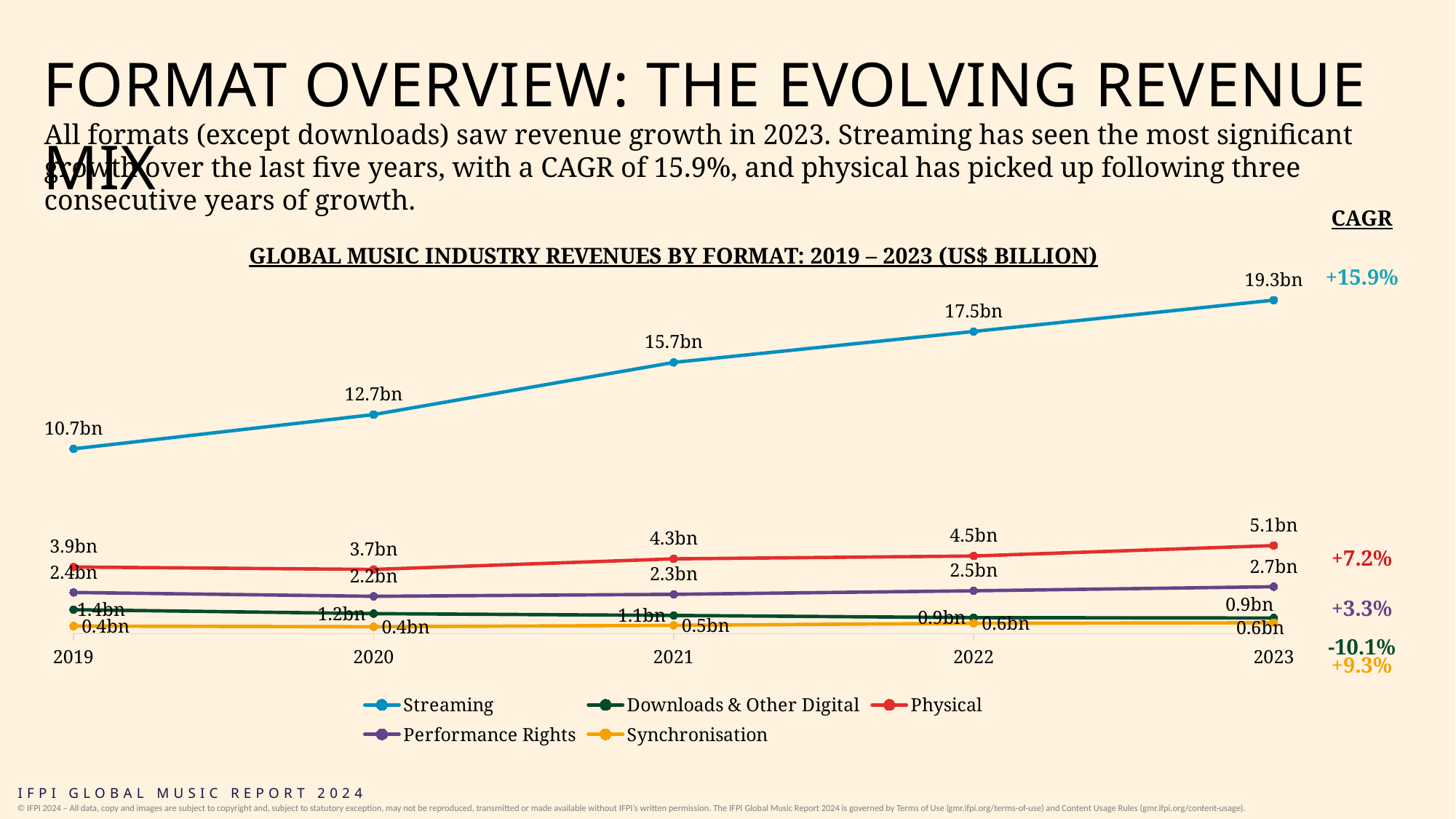
Which format had the highest revenue in 2023? Streaming By how much did Streaming revenue increase from 2019 to 2023? 8.6bn What was Performance Rights revenue in 2022? 2.5bn How many series does the legend list? 5 What type of chart is shown on the slide? Line chart Which was larger in 2020: Downloads & Other Digital or Performance Rights? Performance Rights What was Streaming revenue in 2023? 19.3bn Which format had the lowest revenue in 2021? Synchronisation How many years are shown on the x axis? 5 What was Synchronisation revenue in 2019? 0.4bn Does Downloads & Other Digital revenue rise or fall from 2019 to 2023? Fall What was Physical revenue in 2020? 3.7bn